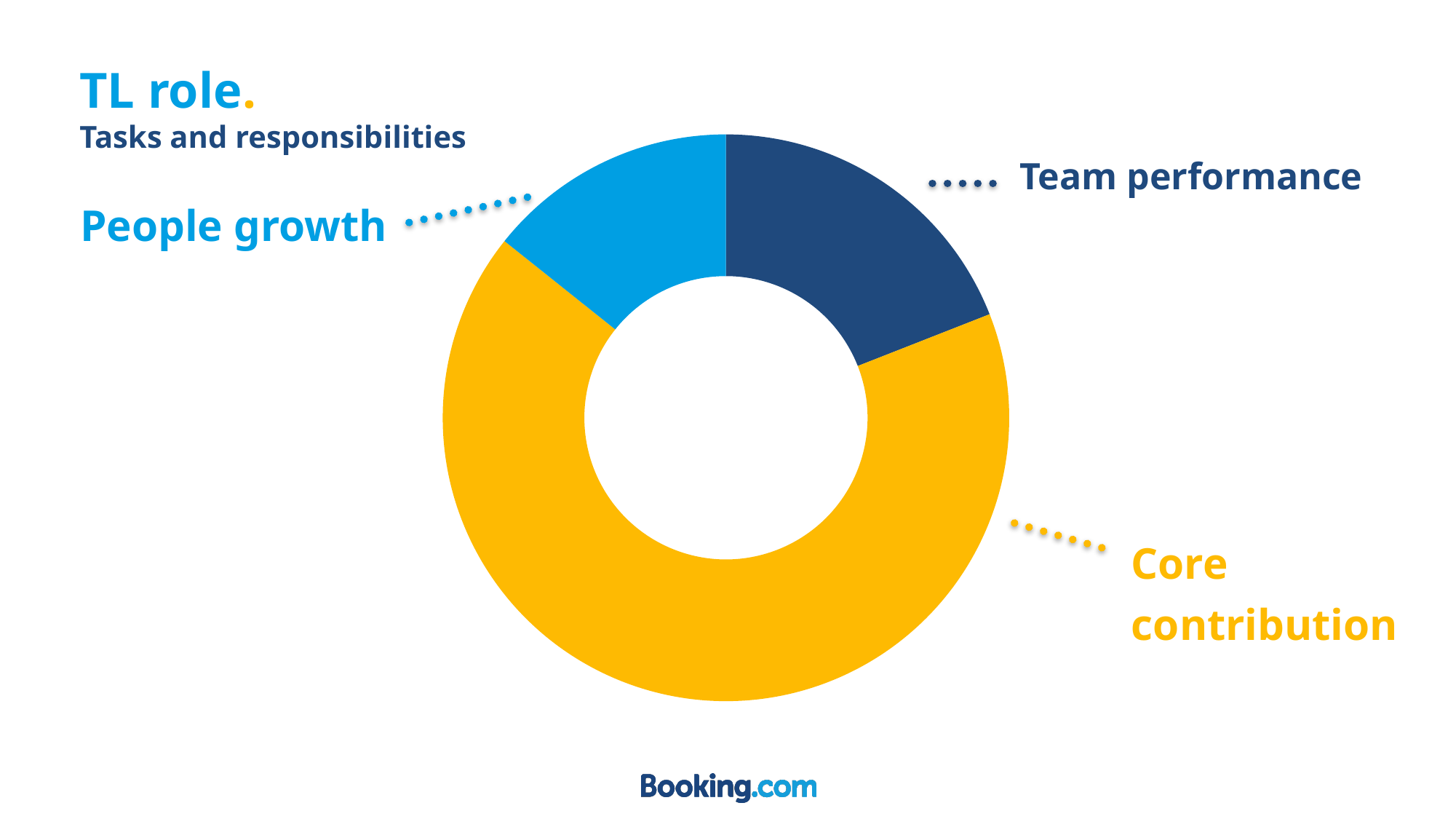
What kind of chart is shown on the slide? Pie chart (donut) What is the title of the slide containing the chart? TL role. Tasks and responsibilities Which segment is larger, Core contribution or Team performance? Core contribution How many segments does the chart have? 3 Which segment is larger, Team performance or People growth? Team performance Which segment is the smallest in the chart? People growth What colour is the Core contribution segment? Yellow Which segment is the largest in the chart? Core contribution Does Core contribution take up more or less than half of the chart? More